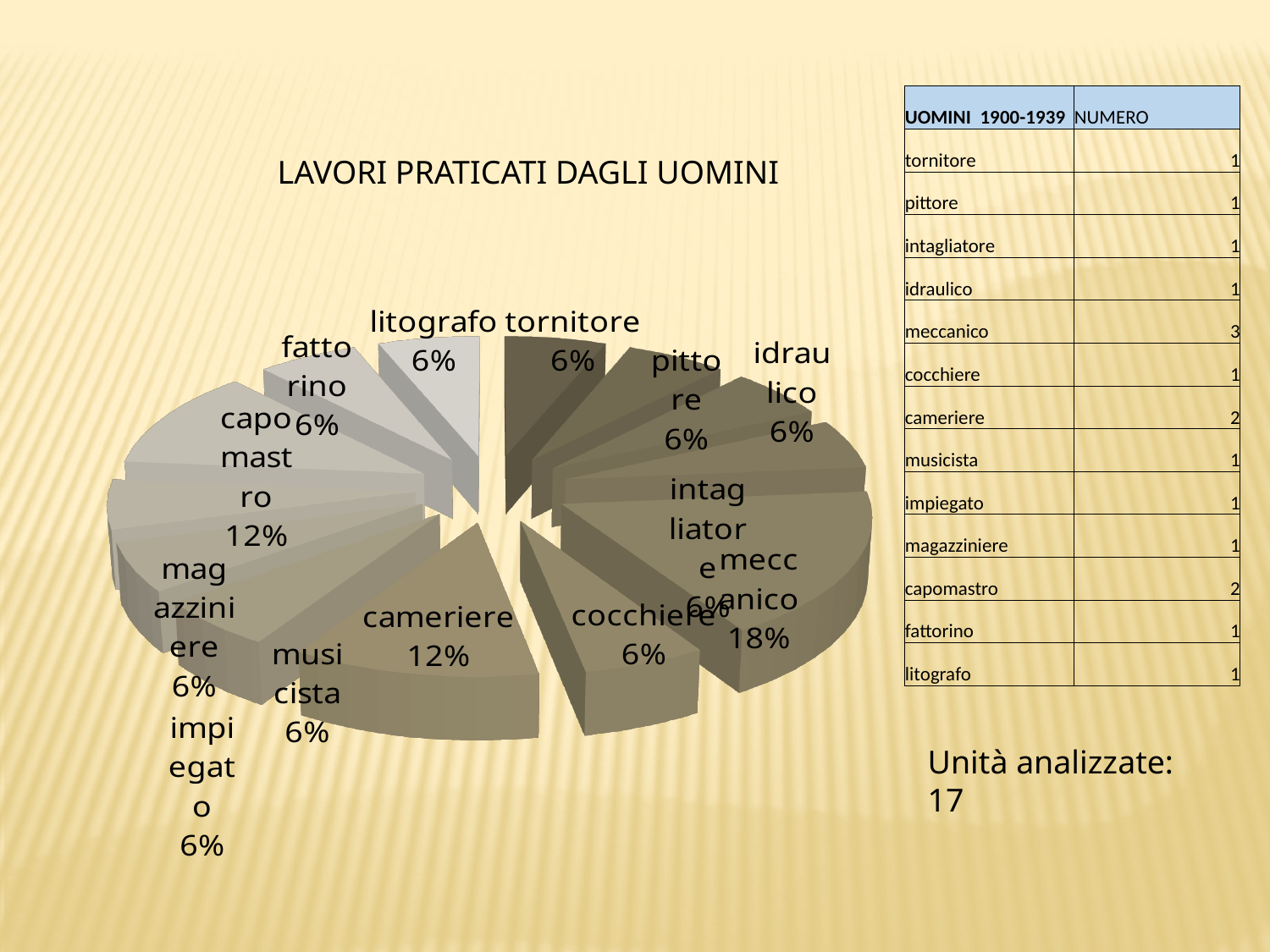
What percentage share does litografo have in the pie chart? 6% Which is larger in the pie chart, the share for meccanico or the share for cocchiere? meccanico What is the difference in percentage points between the meccanico slice and the cameriere slice? 6 What percentage share does tornitore have in the pie chart? 6% What type of chart is shown on the slide? pie chart What is the title of the pie chart? LAVORI PRATICATI DAGLI UOMINI What percentage share does capomastro have in the pie chart? 12% How many slices does the pie chart have? 13 Which is larger in the pie chart, the share for capomastro or the share for musicista? capomastro Which category has the largest slice in the pie chart? meccanico